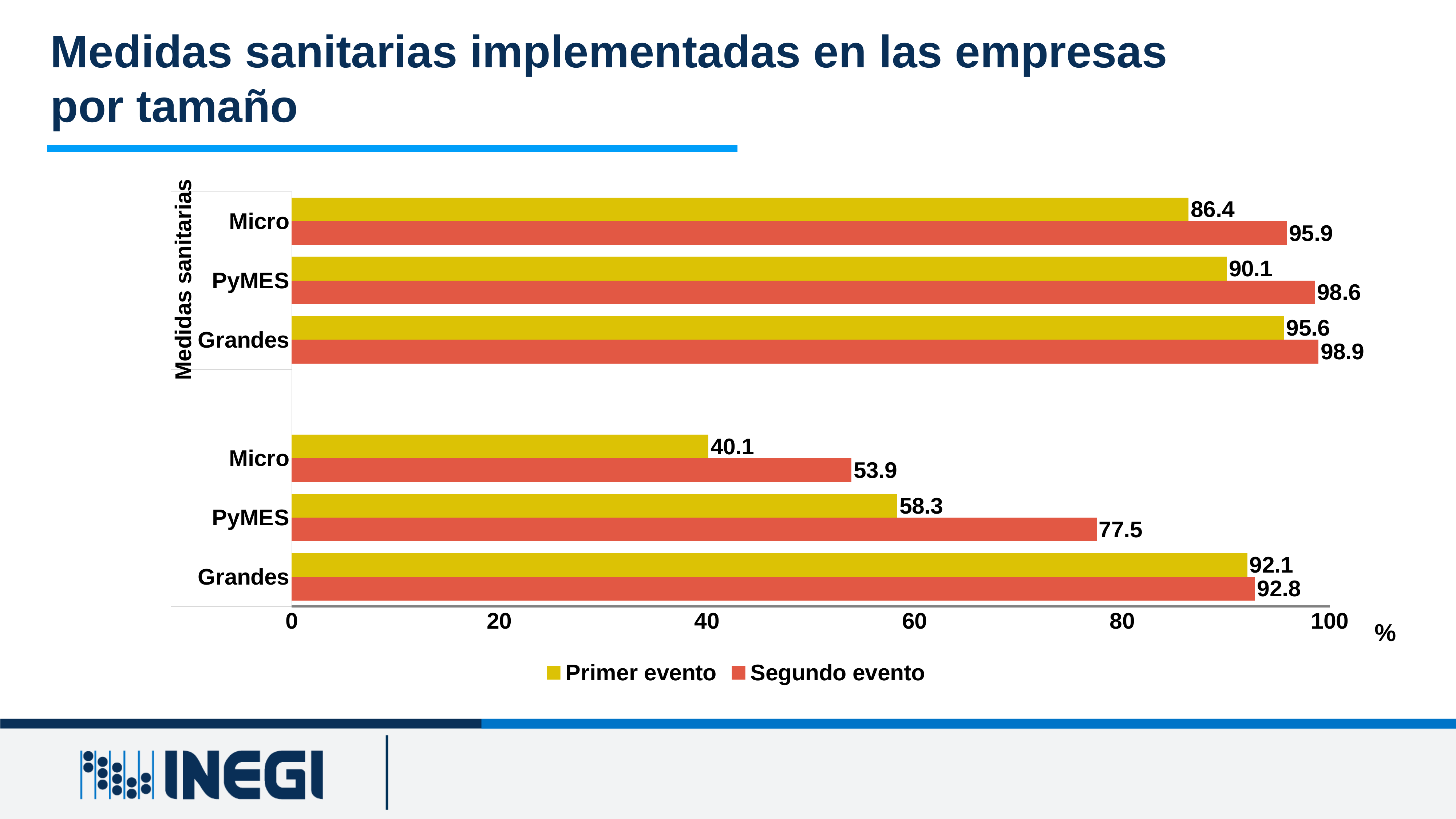
In the lower group of bars, which category has the lowest Primer evento value? Micro How many series does the legend list? 2 In the lower group of bars, what is the Primer evento value for Micro? 40.1 What kind of chart is shown on the slide? Bar chart In the Medidas sanitarias group, what is the Segundo evento value for PyMES? 98.6 In the Medidas sanitarias group, which category has the highest Segundo evento value? Grandes In the Medidas sanitarias group, what is the difference between the Segundo evento and Primer evento values for Micro? 9.5 What colour are the Segundo evento bars? Red In the lower group of bars, what is the difference between the Segundo evento and Primer evento values for Micro? 13.8 In the lower group of bars, what is the Segundo evento value for PyMES? 77.5 In the lower group of bars, is the Primer evento value for PyMES larger or the Segundo evento value for PyMES? Segundo evento In the Medidas sanitarias group, what is the Primer evento value for Micro? 86.4